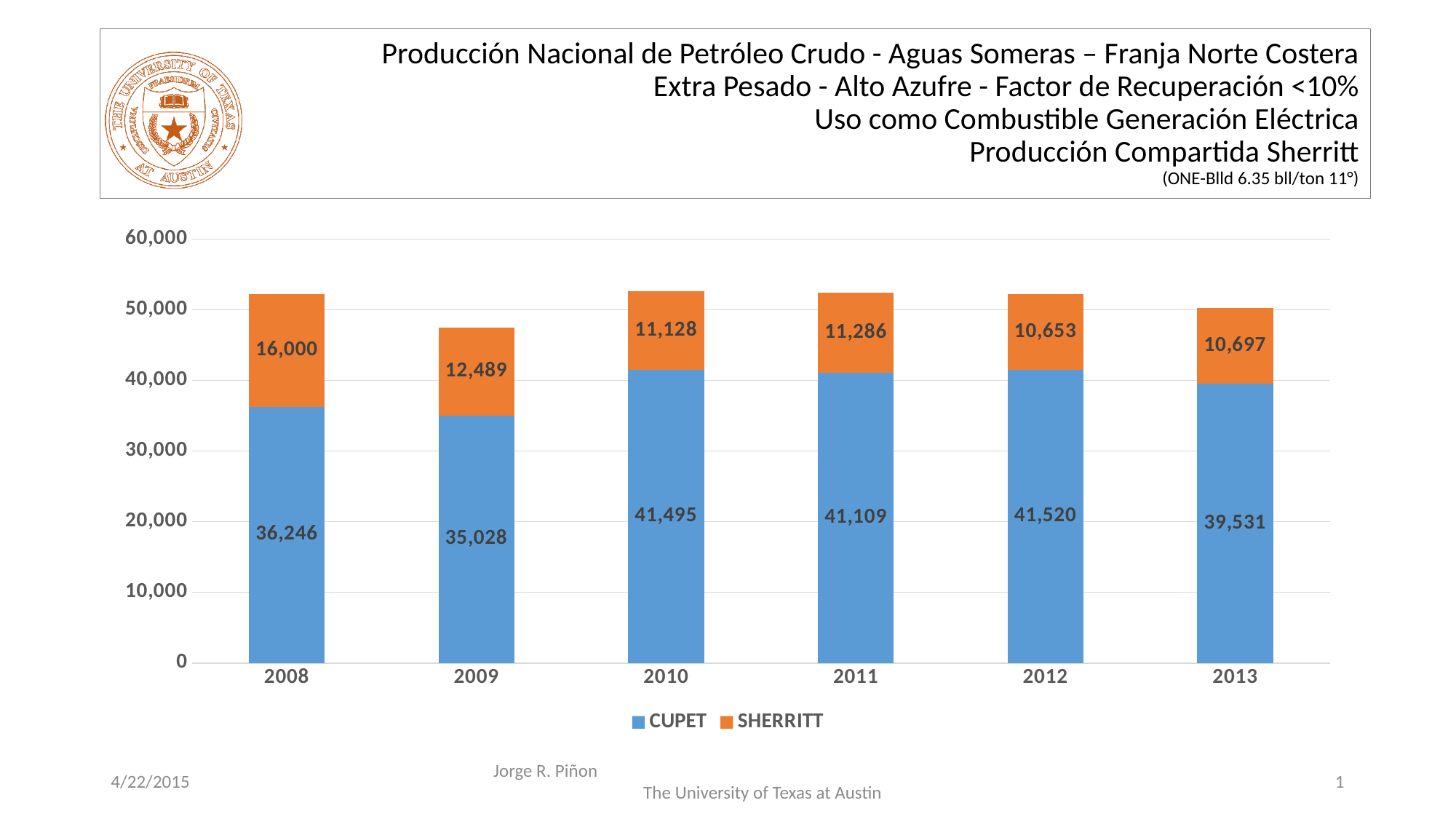
Does the SHERRITT value rise or fall from 2008 to 2010? fall In which year is the SHERRITT value highest? 2008 How many series does the legend list? 2 What is the SHERRITT value for 2013? 10,697 What is the total of the stacked bar for 2008? 52,246 What kind of chart is shown on the slide? stacked bar chart Which is larger, the CUPET value for 2010 or for 2011? 2010 In which year is the CUPET value lowest? 2009 What is the CUPET value for 2010? 41,495 Is the total stacked bar for 2009 greater or less than 50,000? less What is the difference between the SHERRITT values for 2008 and 2009? 3,511 How many years are shown on the x axis? 6